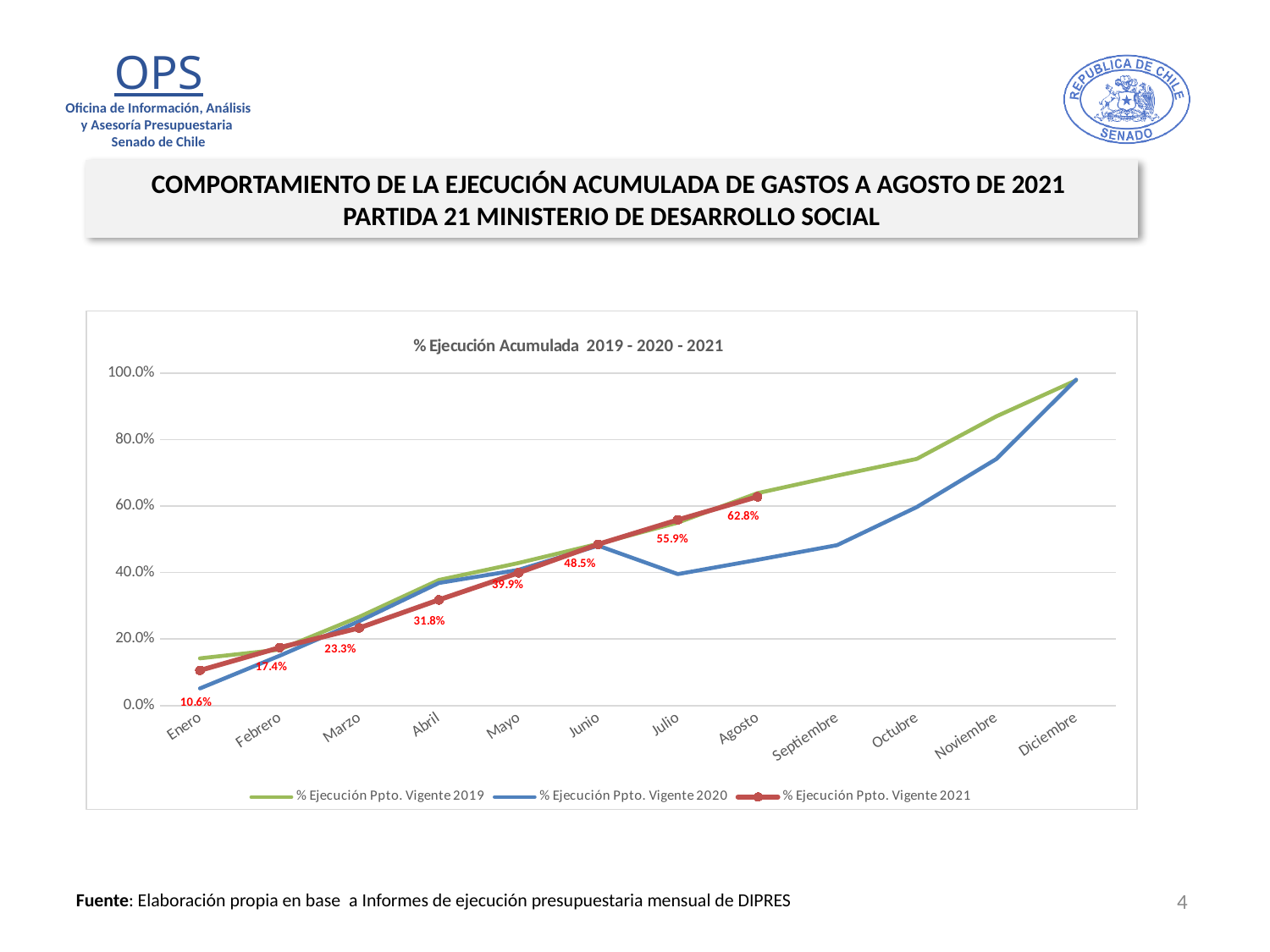
What is the value of % Ejecución Ppto. Vigente 2021 for Junio? 48.5% How many series does the legend list? 3 What kind of chart is shown? Line chart What is the difference between the 2021 values for Agosto and Julio? 6.9 percentage points What is the value of % Ejecución Ppto. Vigente 2021 for Agosto? 62.8% How many months are shown on the x axis? 12 In Noviembre, which series is higher: % Ejecución Ppto. Vigente 2019 or % Ejecución Ppto. Vigente 2020? % Ejecución Ppto. Vigente 2019 Which month has the lowest value for % Ejecución Ppto. Vigente 2021? Enero What is the value of % Ejecución Ppto. Vigente 2021 for Enero? 10.6% Is the value for % Ejecución Ppto. Vigente 2020 in Noviembre greater or less than 60.0%? greater Which month has the highest value for % Ejecución Ppto. Vigente 2021? Agosto What is the value of % Ejecución Ppto. Vigente 2021 for Abril? 31.8%